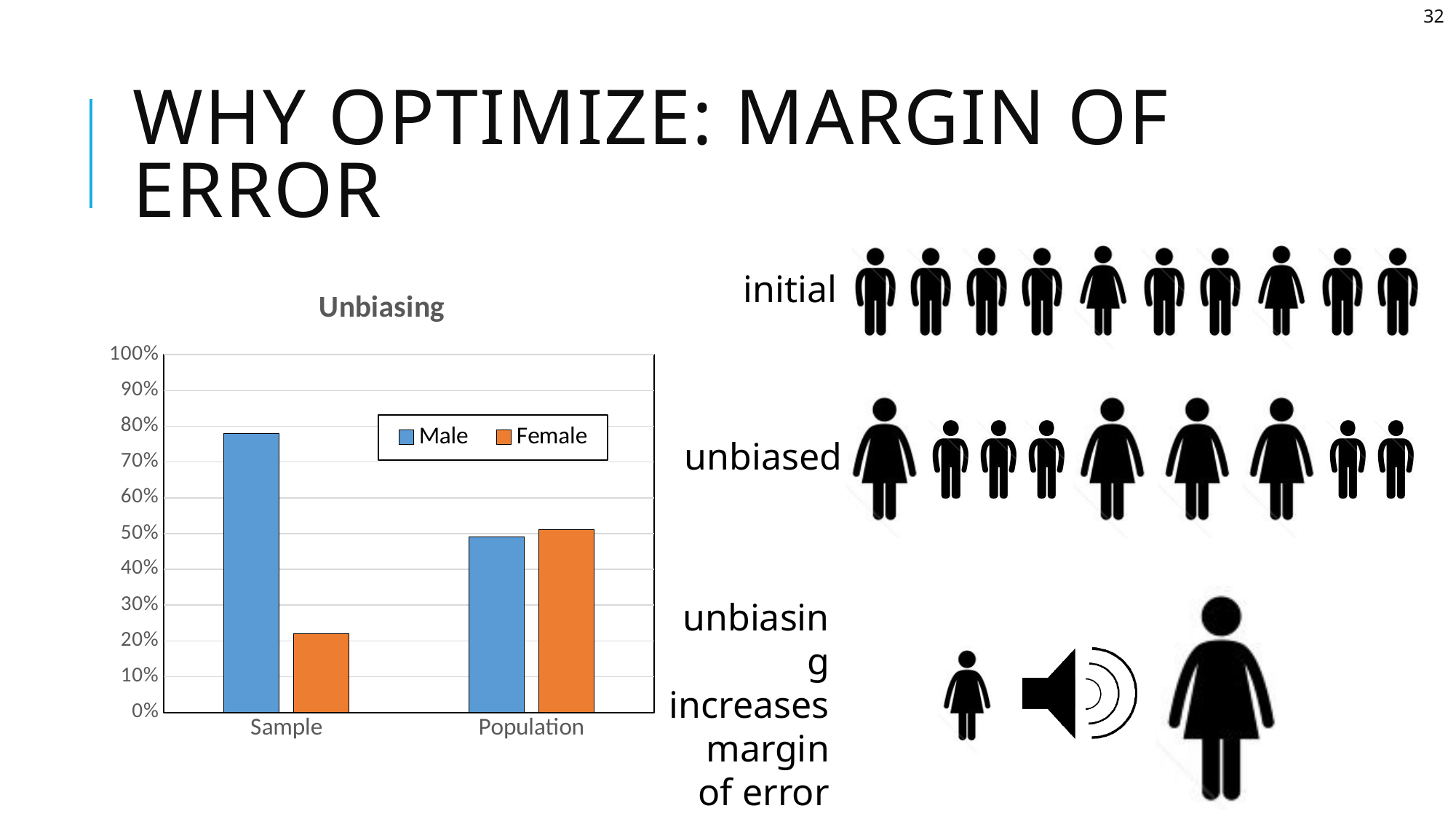
Is the Female value for Population greater or less than 60%? less Which bar is the lowest in the chart? Female in Sample What is the title of the chart? Unbiasing How many series does the chart's legend list? 2 In the Sample category, which is larger, Male or Female? Male What kind of chart is shown on the slide? bar chart How many categories are shown on the x axis of the chart? 2 Is the Female value for Sample greater or less than 30%? less Which category has the tallest bar in the chart? Sample Is the Male value for Sample greater or less than 70%? greater Which series are listed in the chart's legend? Male and Female